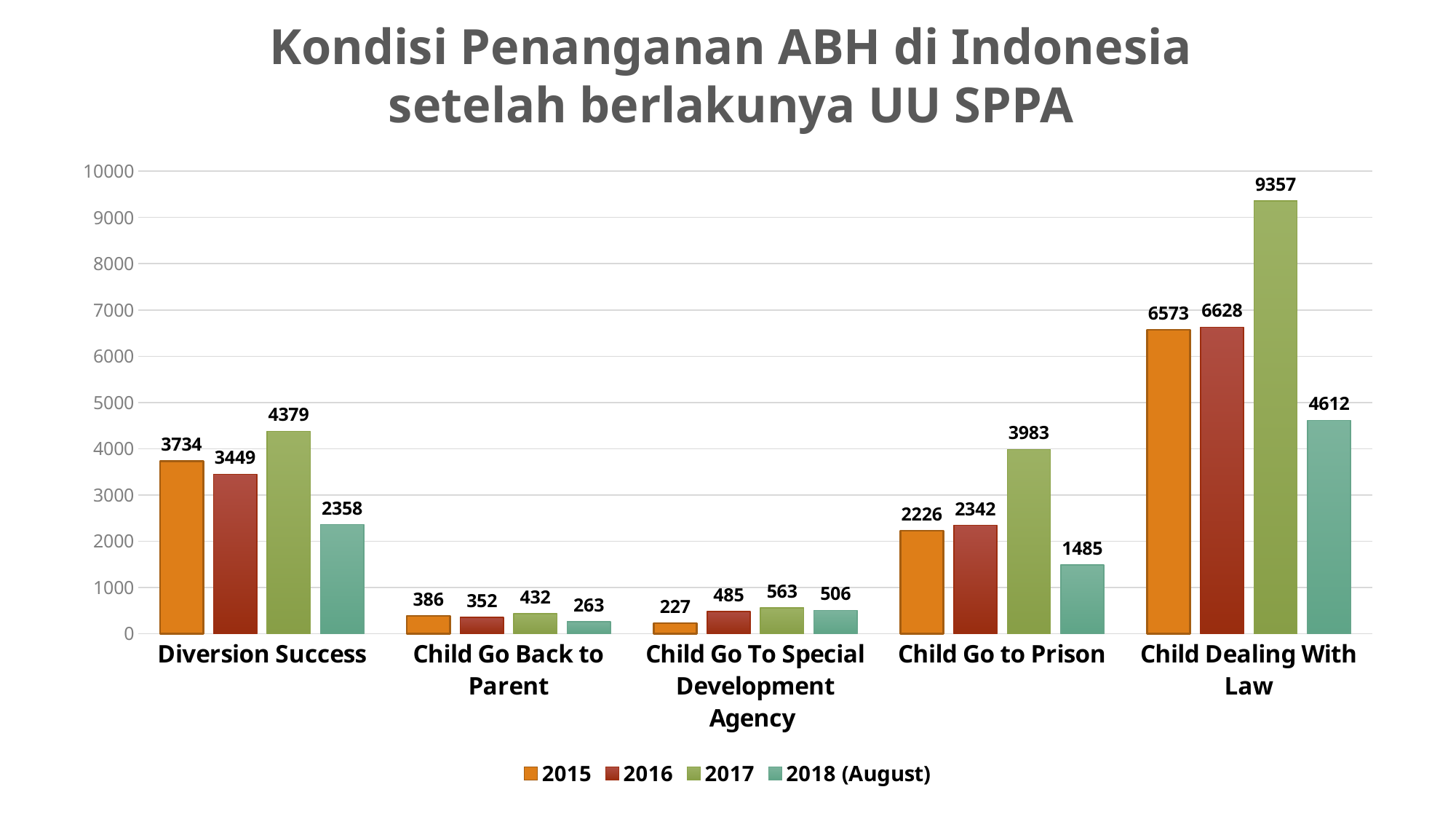
How many categories are shown on the x axis? 5 What kind of chart is shown on the slide? bar chart How many series does the legend list? 4 What is the value for Diversion Success in 2017? 4379 Which is larger for Child Go to Prison: the 2015 value or the 2016 value? 2016 What is the value for Child Go to Prison in 2018 (August)? 1485 Which category has the highest value in 2017? Child Dealing With Law Is the value for Diversion Success in 2018 (August) greater or less than 3000? less What is the difference between the 2017 and 2015 values for Child Dealing With Law? 2784 What is the value for Child Go To Special Development Agency in 2015? 227 Which category has the lowest value in 2018 (August)? Child Go Back to Parent What is the title of the chart? Kondisi Penanganan ABH di Indonesia setelah berlakunya UU SPPA